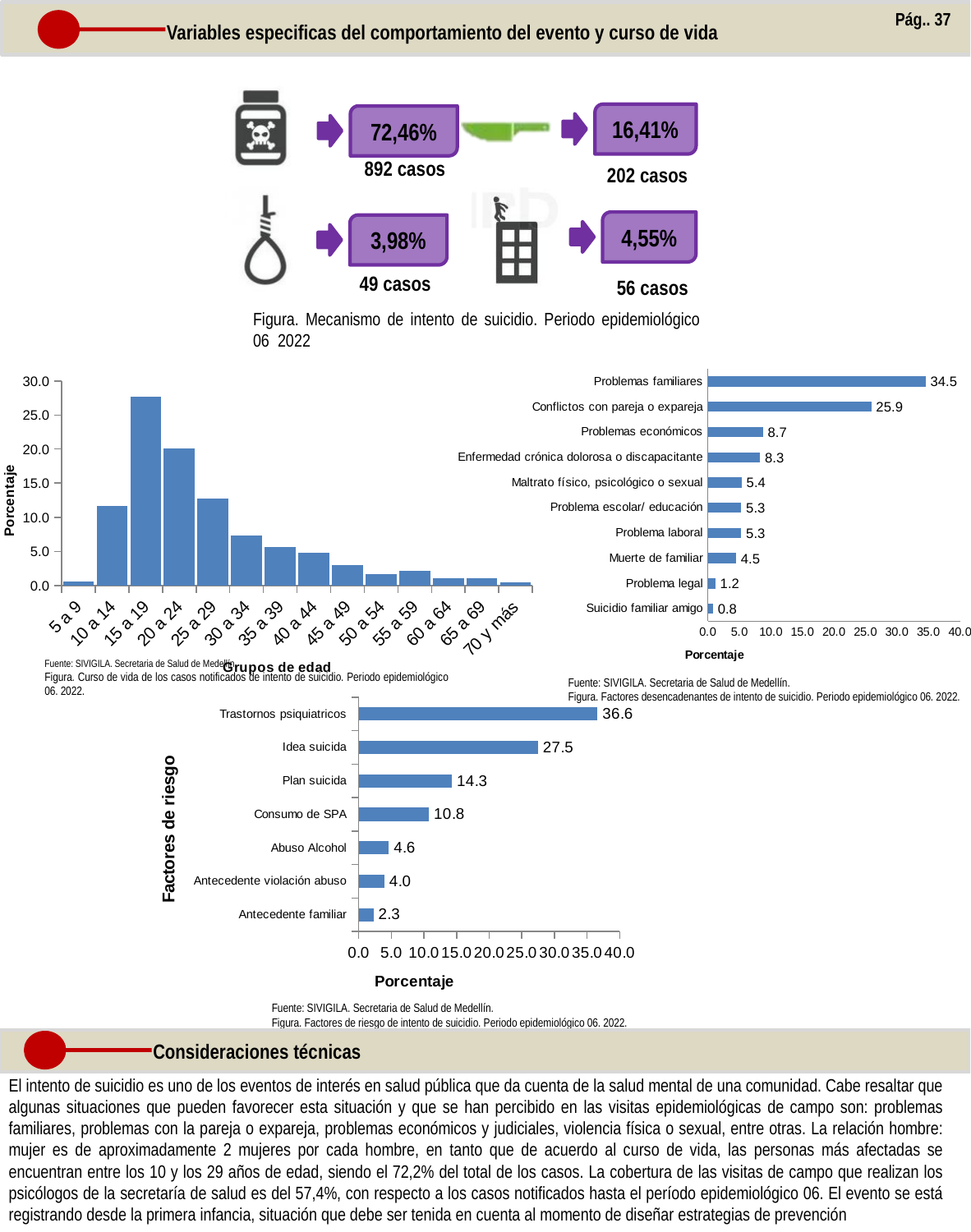
In the 'Factores de riesgo' chart at the bottom, which category has the highest value? Trastornos psiquiatricos In the 'Factores desencadenantes' chart on the right, what is the value for Problemas familiares? 34.5 What kind of chart is the age group chart on the left ('Grupos de edad')? bar chart In the age group chart on the left ('Grupos de edad'), is the value for 15 a 19 greater or less than 25.0? greater In the age group chart on the left ('Grupos de edad'), which age group has the highest percentage? 15 a 19 In the 'Factores desencadenantes' chart on the right, what is the difference between Problemas familiares and Conflictos con pareja o expareja? 8.6 In the 'Factores desencadenantes' chart on the right, how many categories are plotted? 10 In the 'Factores de riesgo' chart at the bottom, what is the difference between Trastornos psiquiatricos and Idea suicida? 9.1 In the 'Factores de riesgo' chart at the bottom, which is larger: Abuso Alcohol or Antecedente violación abuso? Abuso Alcohol In the 'Factores desencadenantes' chart on the right, which category has the lowest value? Suicidio familiar amigo In the 'Factores de riesgo' chart at the bottom, what is the value for Consumo de SPA? 10.8 In the 'Factores de riesgo' chart at the bottom, how many categories are plotted? 7